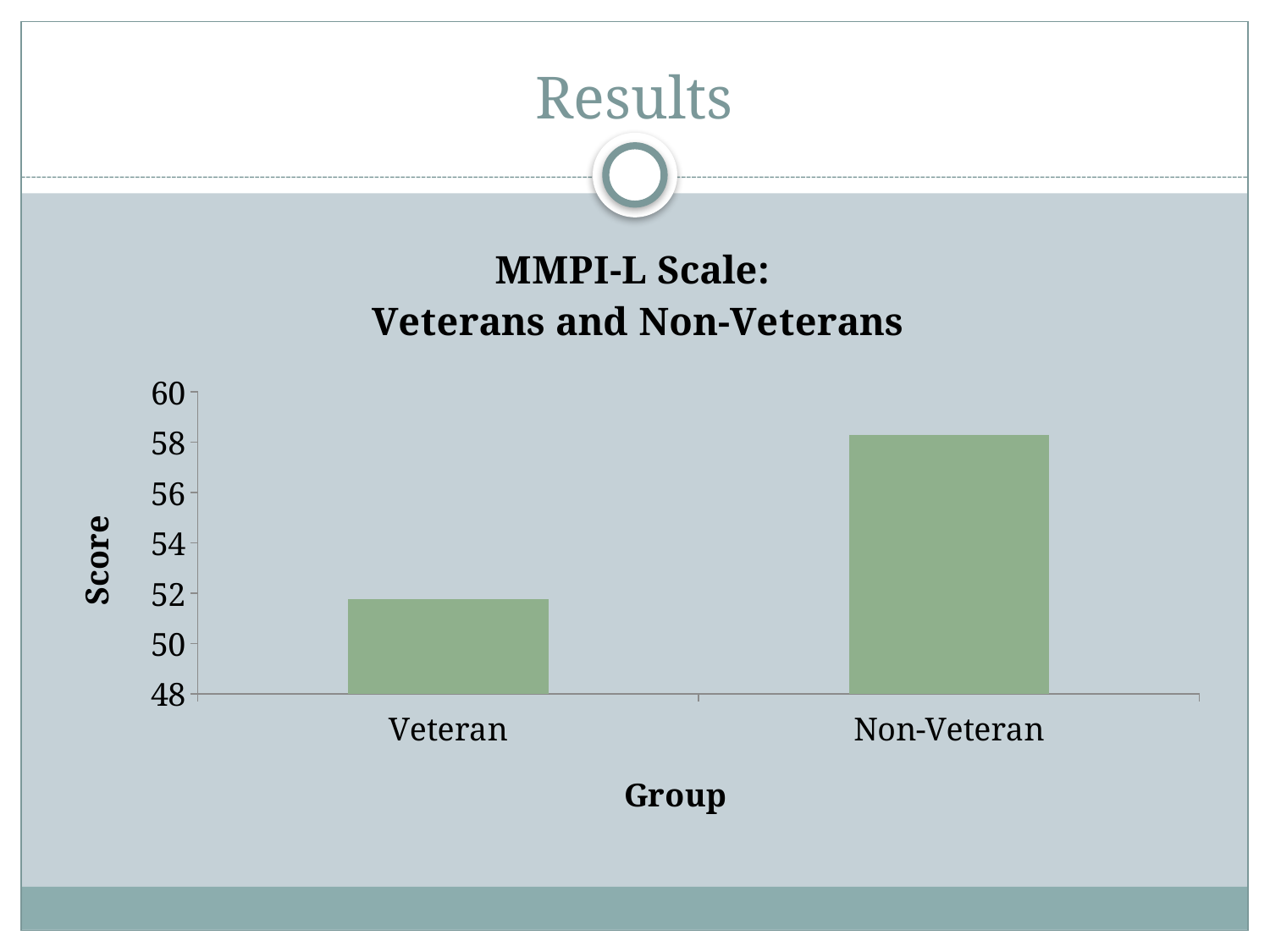
How many groups are plotted in the chart? 2 Do the scores rise or fall from Veteran to Non-Veteran along the x axis? rise Is the score for Non-Veteran greater or less than 60? less Which group has the larger score, Veteran or Non-Veteran? Non-Veteran Is the score for Veteran greater or less than 50? greater What is the label of the vertical axis? Score What kind of chart is shown on the slide? bar chart Which group has the highest score? Non-Veteran Which group has the lowest score? Veteran What is the title of the chart? MMPI-L Scale: Veterans and Non-Veterans